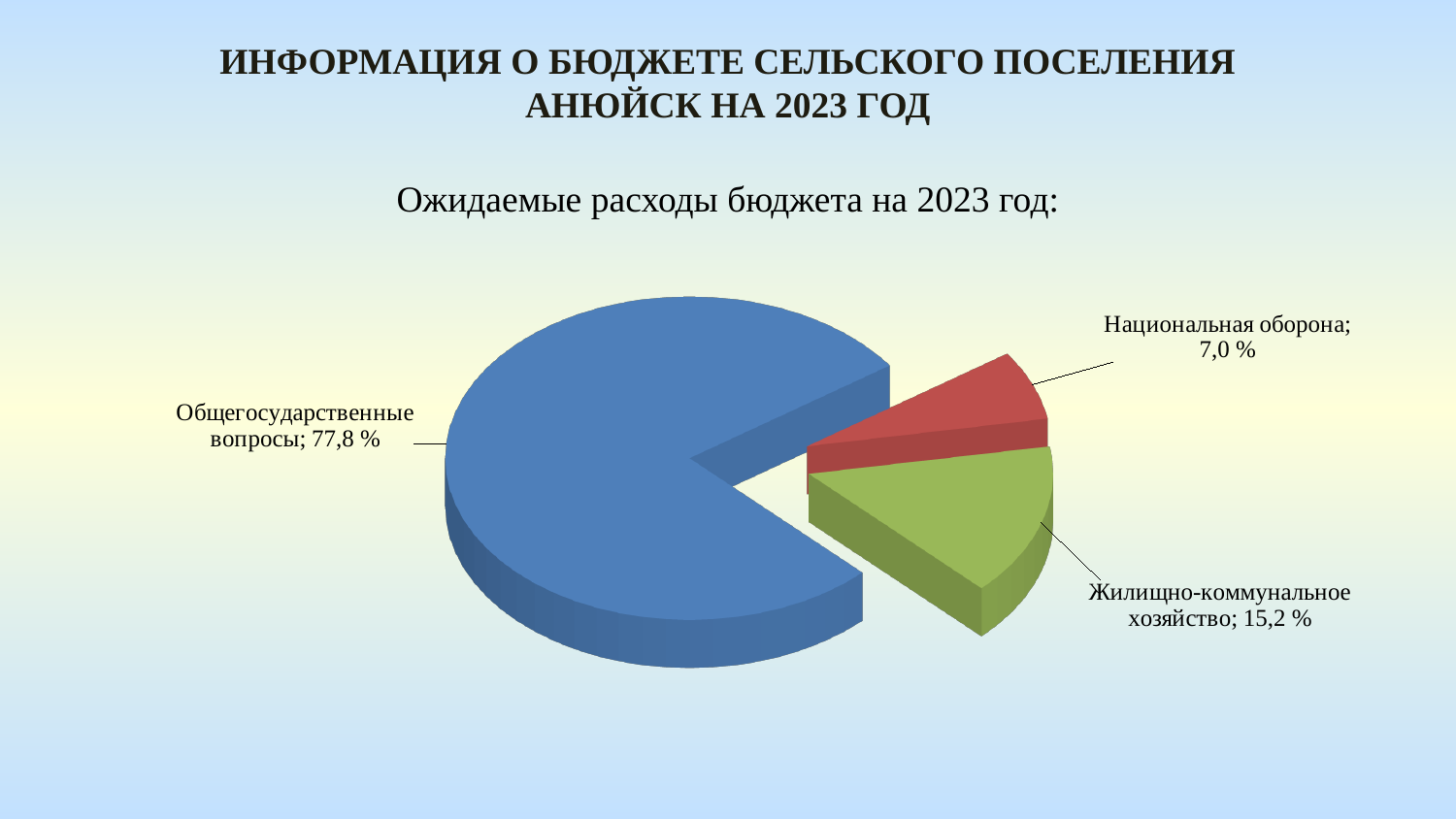
What is the difference in percentage points between Жилищно-коммунальное хозяйство and Национальная оборона? 8,2 What is the difference in percentage points between Общегосударственные вопросы and Жилищно-коммунальное хозяйство? 62,6 How many expenditure categories are shown in the pie chart? 3 What kind of chart is shown on the slide? Pie chart What share of expected 2023 budget expenditures goes to Национальная оборона? 7,0 % Which expenditure category has the smallest share of the pie? Национальная оборона What is the heading above the chart? Ожидаемые расходы бюджета на 2023 год: Which is larger: the share for Жилищно-коммунальное хозяйство or for Национальная оборона? Жилищно-коммунальное хозяйство Which expenditure category has the largest share of the pie? Общегосударственные вопросы What share of expected 2023 budget expenditures goes to Жилищно-коммунальное хозяйство? 15,2 % What share of expected 2023 budget expenditures goes to Общегосударственные вопросы? 77,8 % What colour is the slice for Национальная оборона? Red